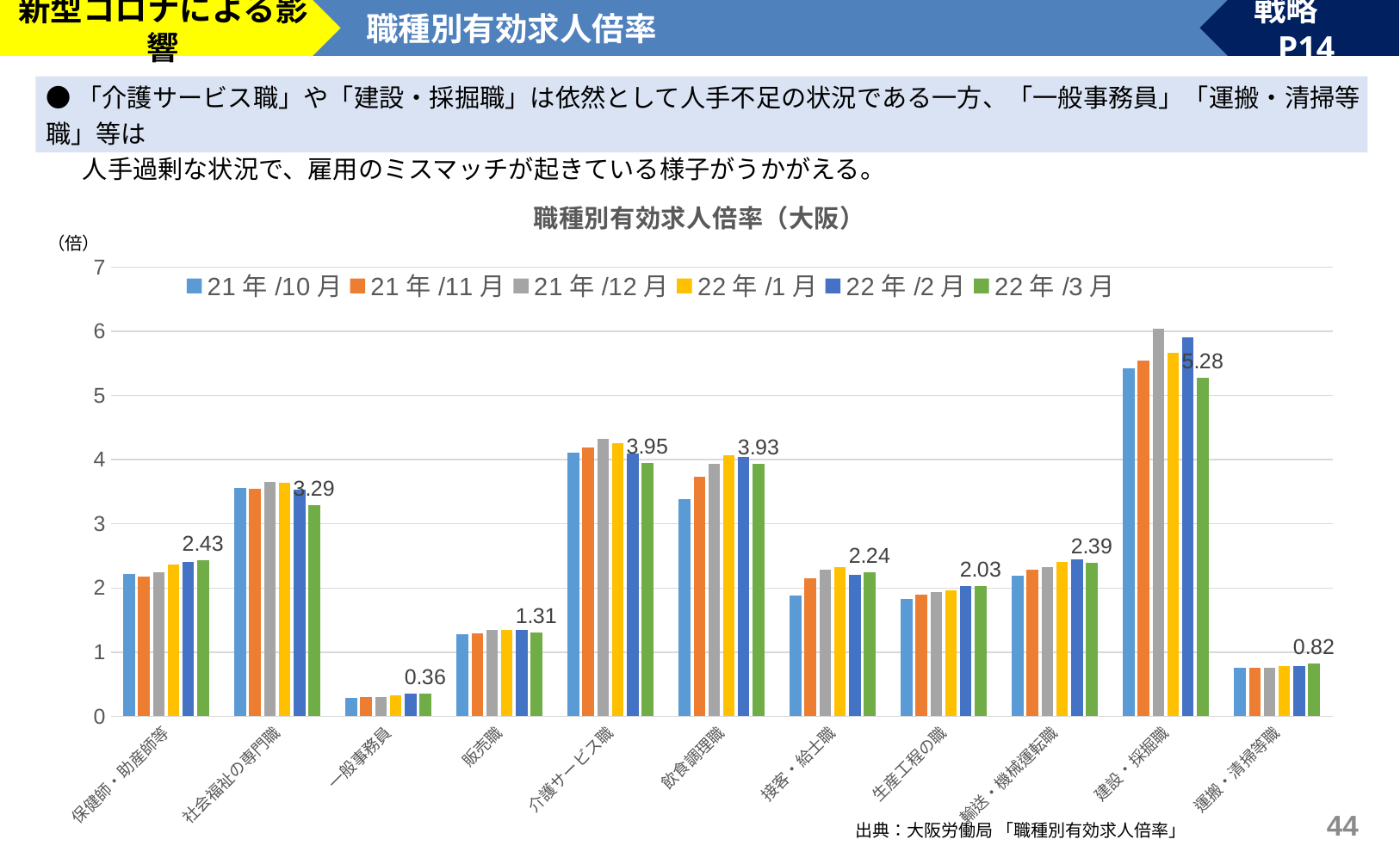
Which occupation has the highest 22年/3月 value? 建設・採掘職 Is the 21年/12月 value for 建設・採掘職 greater or less than 5? greater Which is larger for 22年/3月: 社会福祉の専門職 or 輸送・機械運転職? 社会福祉の専門職 What kind of chart is shown on the slide? bar chart What is the 22年/3月 value for 一般事務員? 0.36 What is the 22年/3月 value for 運搬・清掃等職? 0.82 What is the 22年/3月 value for 建設・採掘職? 5.28 How many occupation categories are shown on the x axis? 11 How many series does the legend list? 6 Which occupation has the lowest 22年/3月 value? 一般事務員 What is the difference between the 22年/3月 values for 建設・採掘職 and 一般事務員? 4.92 What is the 22年/3月 value for 介護サービス職? 3.95